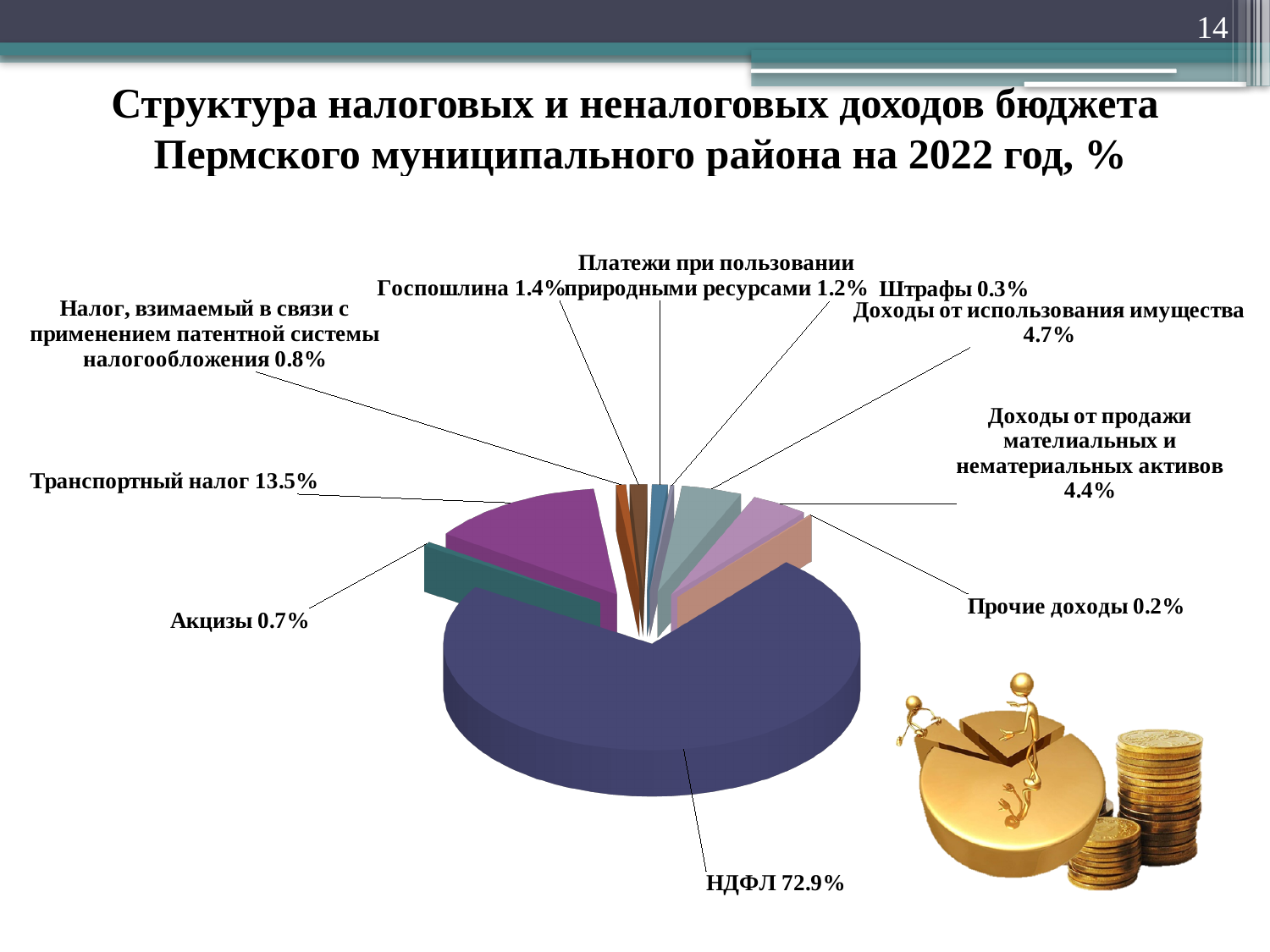
What is the value shown for Транспортный налог? 13.5% How many categories are shown in the pie chart? 10 What is the difference between the shares of НДФЛ and Транспортный налог? 59.4% Which category has the smallest share of the pie? Прочие доходы What kind of chart is shown on the slide? Pie chart Which category has the largest share of the pie? НДФЛ What is the value shown for Доходы от использования имущества? 4.7% What is the value shown for Акцизы? 0.7% What is the value shown for Госпошлина? 1.4% What is the share of НДФЛ in the pie chart? 72.9% What year does the chart title refer to? 2022 Which is larger: Доходы от использования имущества or Доходы от продажи мателиальных и нематериальных активов? Доходы от использования имущества